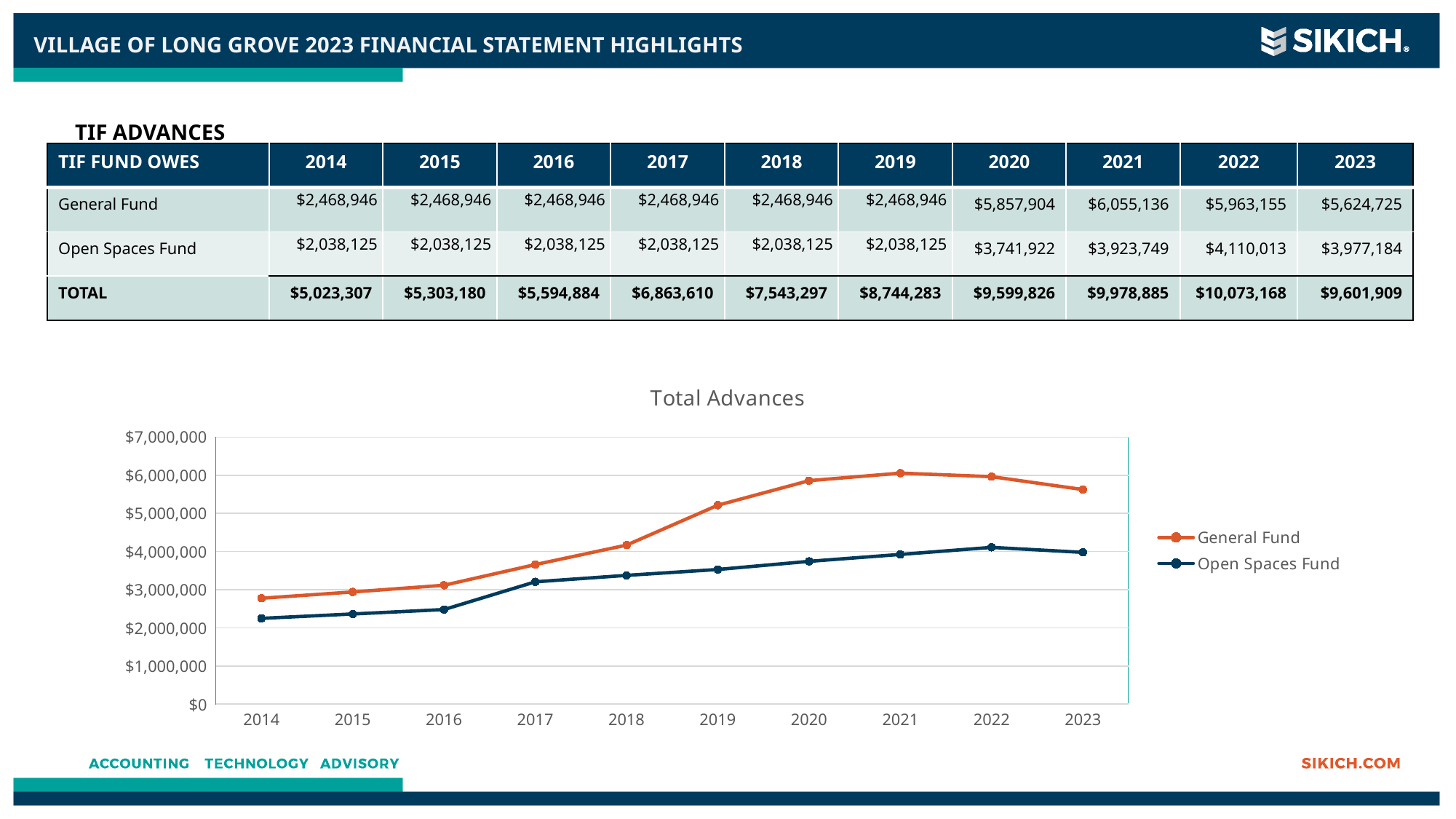
What colour is the General Fund line in the "Total Advances" chart? orange In the "Total Advances" chart, which year has the highest value for the Open Spaces Fund series? 2022 In the "Total Advances" chart, does the General Fund series rise or fall from 2014 to 2021? rise In the "Total Advances" chart, which year has the lowest value for the General Fund series? 2014 In the "Total Advances" chart, is the General Fund value for 2014 greater or less than $3,000,000? less What kind of chart is the "Total Advances" chart? line chart In the "Total Advances" chart, which series has the larger value in 2018, General Fund or Open Spaces Fund? General Fund How many series does the legend of the "Total Advances" chart list? 2 How many years are plotted along the x axis of the "Total Advances" chart? 10 In the "Total Advances" chart, is the General Fund value for 2019 greater or less than $5,000,000? greater In the "Total Advances" chart, is the Open Spaces Fund value for 2017 greater or less than $3,000,000? greater